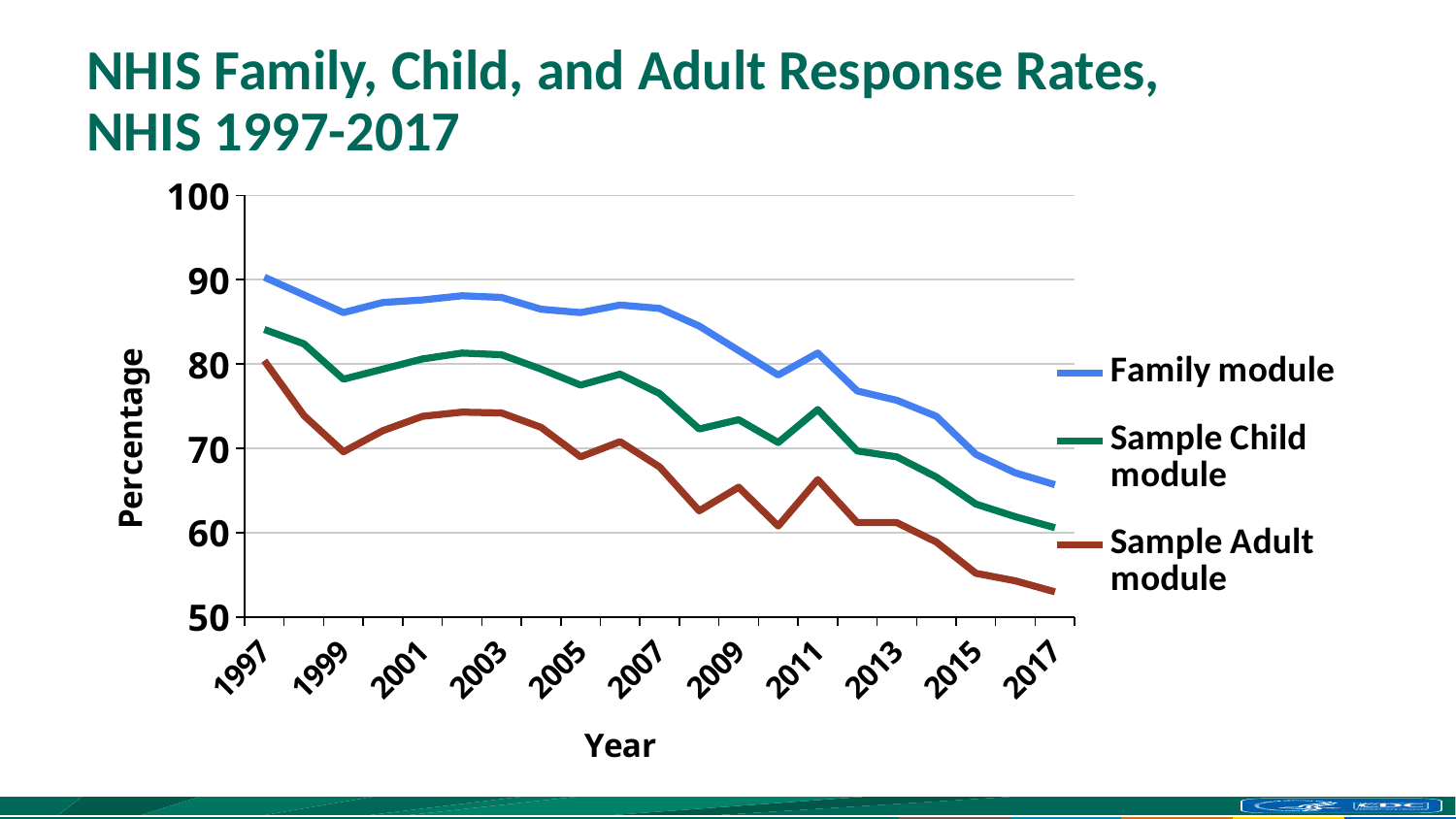
Is the value for the Sample Adult module in 2017 greater or less than 60? less Do the response rates for the Family module rise or fall from 1997 to 2017? fall What kind of chart is shown on the slide? line chart How many series does the legend list? 3 What is the title of the chart? NHIS Family, Child, and Adult Response Rates, NHIS 1997-2017 Is the value for the Sample Child module in 1997 greater or less than 80? greater Which series has the lowest response rate across the whole period? Sample Adult module Is the value for the Family module in 2017 greater or less than 70? less Which series has the highest response rate across the whole period? Family module Which series is shown in blue? Family module In 2017, which is larger: the Family module value or the Sample Adult module value? Family module